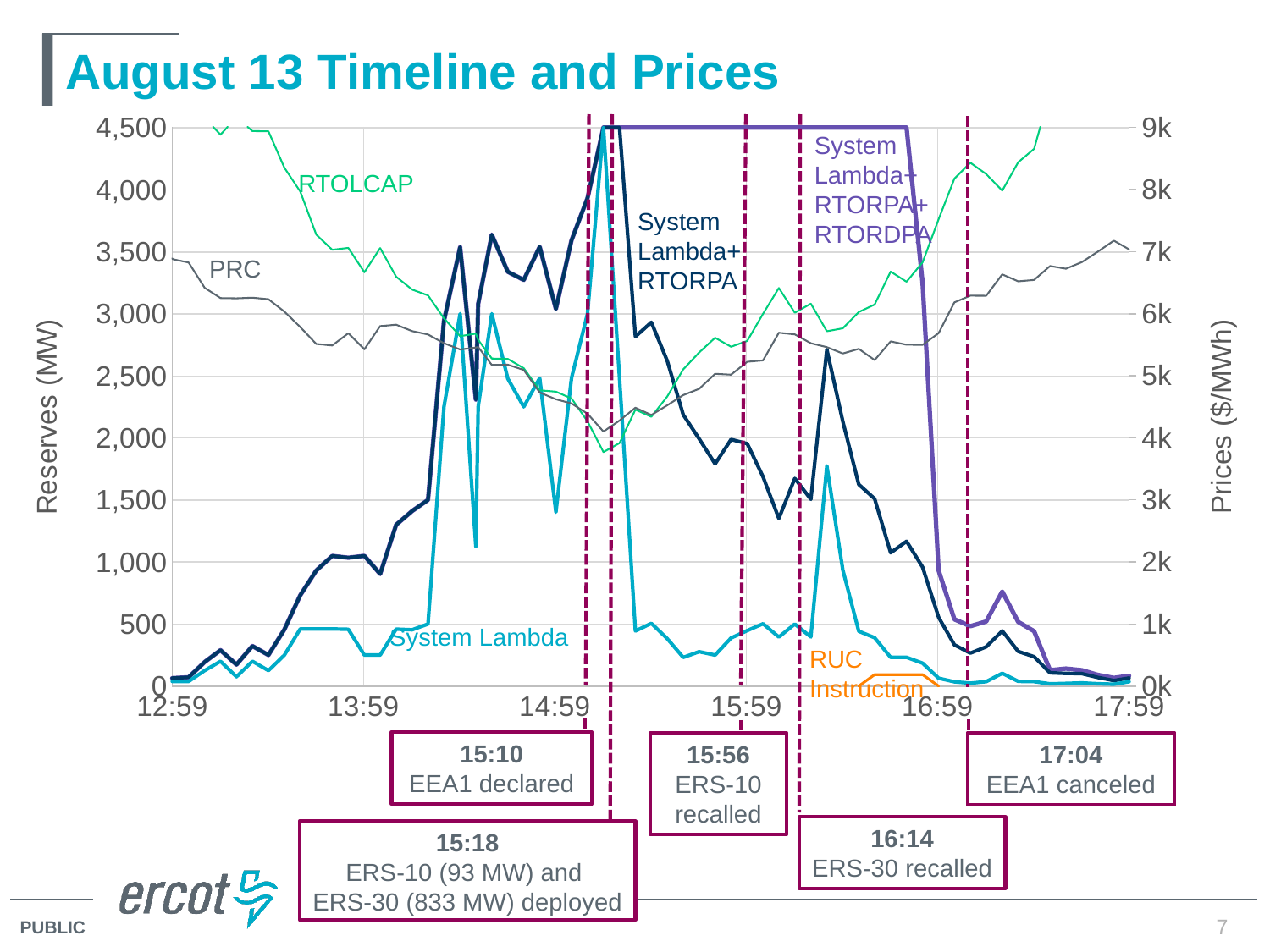
Is the System Lambda value at 17:59 greater or less than 1k $/MWh? less At 13:59, which is larger, RTOLCAP or PRC? RTOLCAP Does the PRC line rise or fall between 12:59 and 14:59? Fall How many MW of ERS-30 were deployed at 15:18 according to the annotation? 833 MW What is the label of the right-hand vertical axis? Prices ($/MWh) What kind of chart is shown on the slide? Line chart How many labelled data series are plotted on the chart? 6 Is the PRC value at 12:59 greater or less than 3,000 MW? greater At what time was EEA1 declared according to the chart annotation? 15:10 What is the title of the chart on the slide? August 13 Timeline and Prices Is the System Lambda+RTORPA+RTORDPA value at 15:59 greater or less than 8k $/MWh? greater How many time labels are shown along the x axis? 6